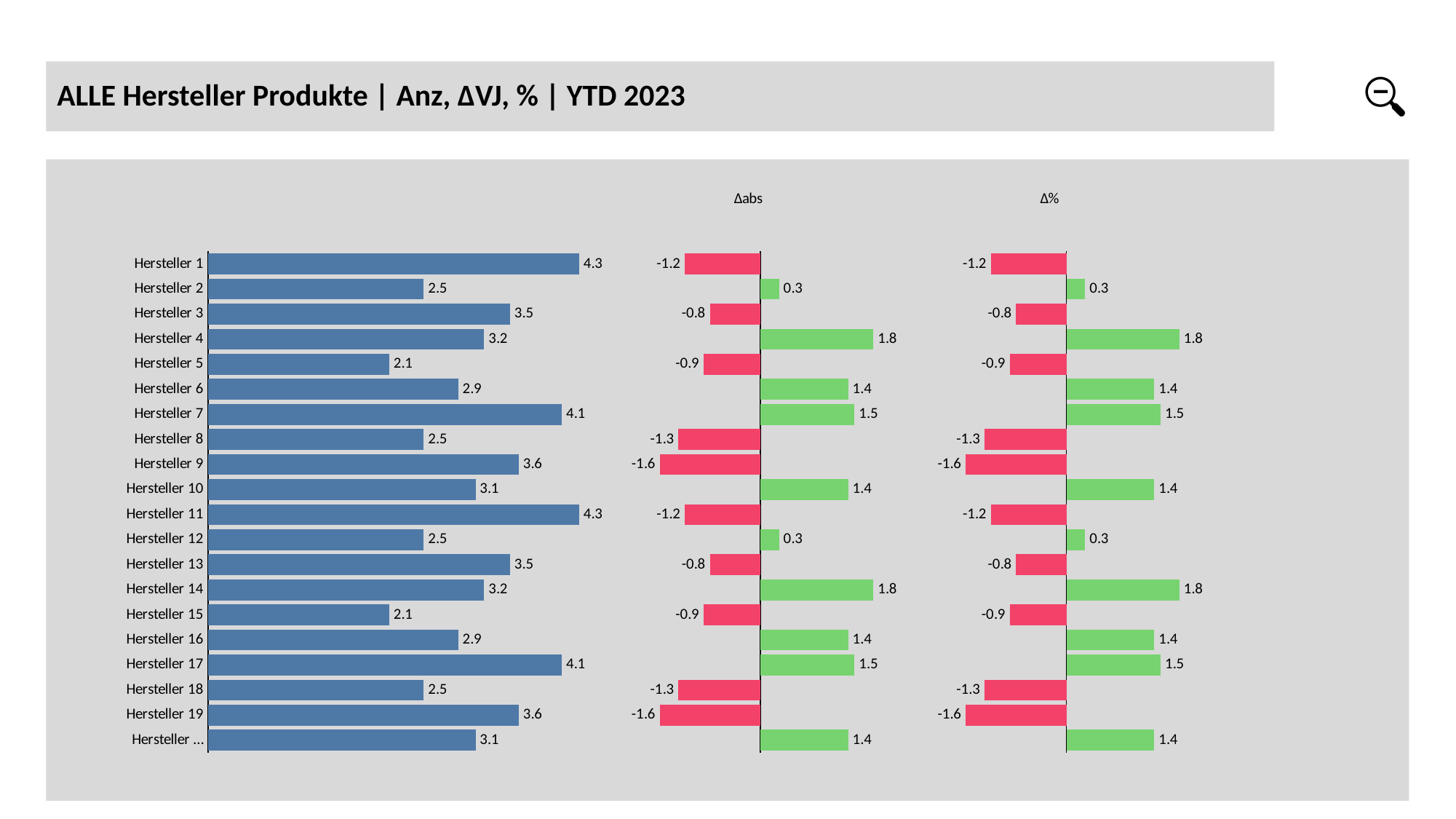
In the Δabs chart, what colour are the bars with negative values? Red How many categories (Hersteller) are shown in the left chart? 20 In the Δabs chart, what is the value for Hersteller 2? 0.3 In the Δabs chart, what is the value for Hersteller 9? -1.6 In the Δabs chart, which is larger, the value for Hersteller 6 or the value for Hersteller 7? Hersteller 7 What is the title of the slide's chart area? ALLE Hersteller Produkte | Anz, ΔVJ, % | YTD 2023 In the left chart, which is larger, the value for Hersteller 3 or the value for Hersteller 6? Hersteller 3 In the Δ% chart, what is the value for Hersteller 4? 1.8 What kind of chart is the left chart? Bar chart In the left chart, what is the difference between the values for Hersteller 1 and Hersteller 2? 1.8 In the left chart, what is the value for Hersteller 7? 4.1 In the left chart, what is the value for Hersteller 5? 2.1